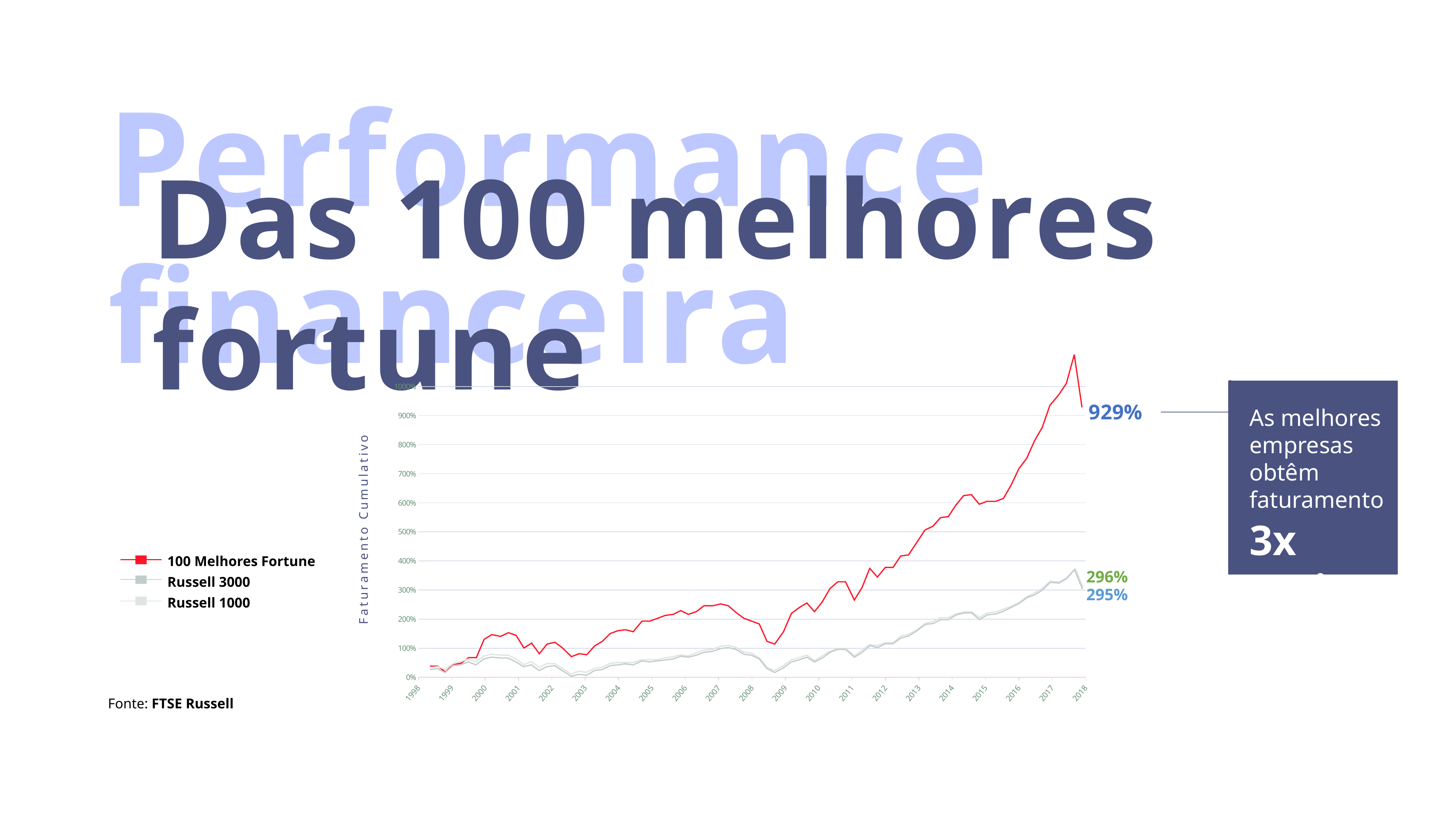
How many year labels are shown on the x axis? 21 What type of chart is shown on the slide? Line chart Which series ends at the highest value in 2018? 100 Melhores Fortune Is the value for 100 Melhores Fortune in 2015 greater or less than 500%? greater How many series does the chart legend list? 3 What is the title of the vertical axis? Faturamento Cumulativo What is the difference between the 929% end label and the 296% end label? 633% In 2018, which is larger: 100 Melhores Fortune or Russell 3000? 100 Melhores Fortune What is the final value labelled for the 100 Melhores Fortune series? 929% Does the 100 Melhores Fortune line rise or fall overall from 1998 to 2018? Rise Which series are listed in the chart legend? 100 Melhores Fortune, Russell 3000, Russell 1000 Is the value for 100 Melhores Fortune in 2009 greater or less than 200%? less